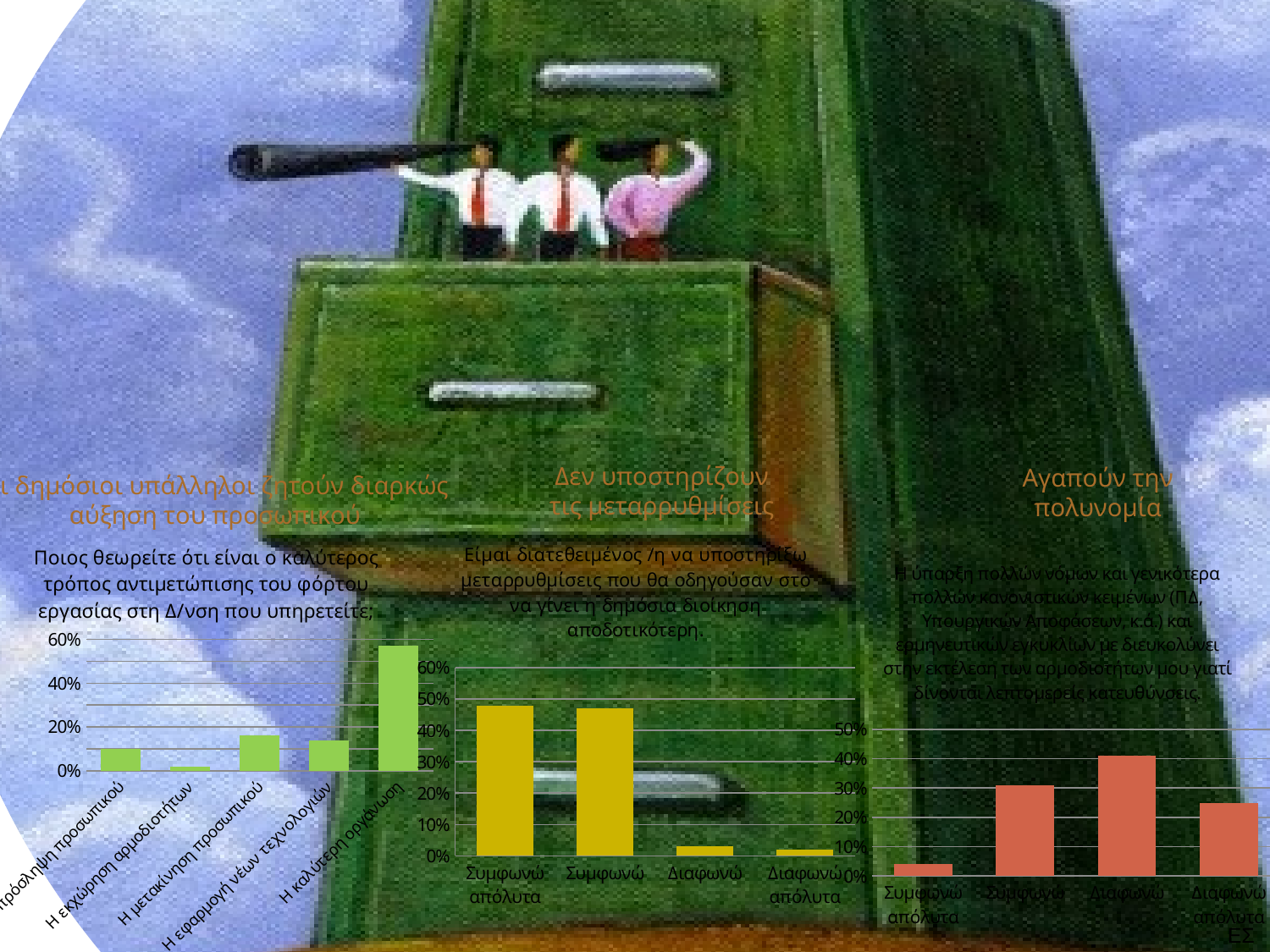
In the left chart, is the value for Η καλύτερη οργάνωση greater or less than 40%? greater In the middle chart, which is larger: Συμφωνώ or Διαφωνώ? Συμφωνώ In the middle chart, is the value for Συμφωνώ απόλυτα greater or less than 40%? greater In the right chart, which category has the lowest value? Συμφωνώ απόλυτα What type of chart is the middle chart? bar chart How many charts are on the slide? 3 In the right chart, which category has the highest value? Διαφωνώ In the left chart, which category has the lowest value? Η εκχώρηση αρμοδιοτήτων In the middle chart, is the value for Διαφωνώ greater or less than 10%? less In the left chart, which category has the highest value? Η καλύτερη οργάνωση In the left chart, how many categories are shown? 5